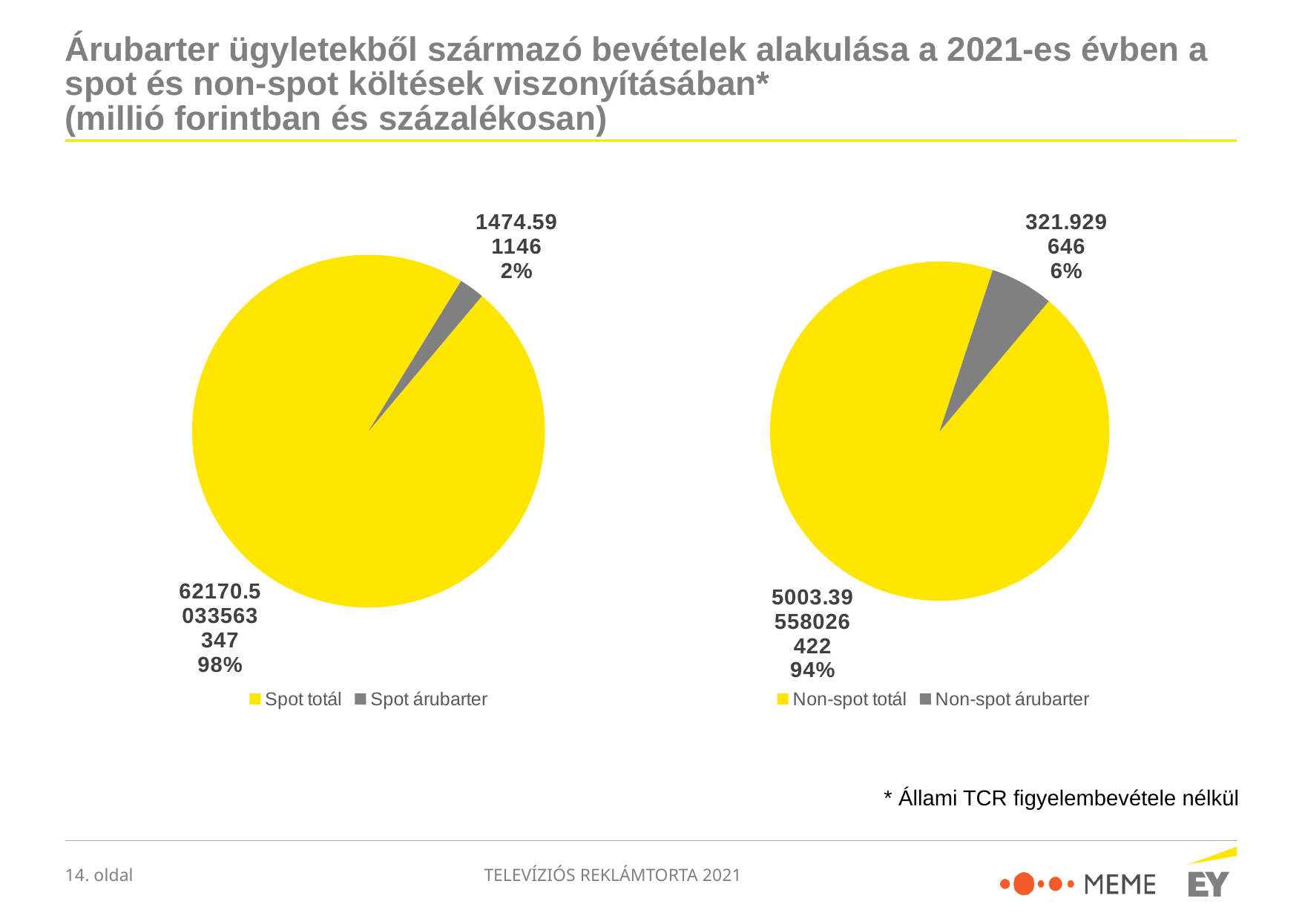
In the right pie chart, which slice is the smallest? Non-spot árubarter How many entries does the legend of the left pie chart list? 2 In the right pie chart, what colour is the Non-spot árubarter slice? grey In the right pie chart, what percentage share does Non-spot totál have? 94% Which is larger: the share of Spot árubarter in the left pie chart or the share of Non-spot árubarter in the right pie chart? Non-spot árubarter What kind of chart is the right chart (Non-spot totál / Non-spot árubarter)? pie chart How many slices does the right pie chart have? 2 What kind of chart is the left chart (Spot totál / Spot árubarter)? pie chart In the right pie chart, what percentage share does Non-spot árubarter have? 6% In the left pie chart, what percentage share does Spot totál have? 98% In the left pie chart, which slice is the largest? Spot totál